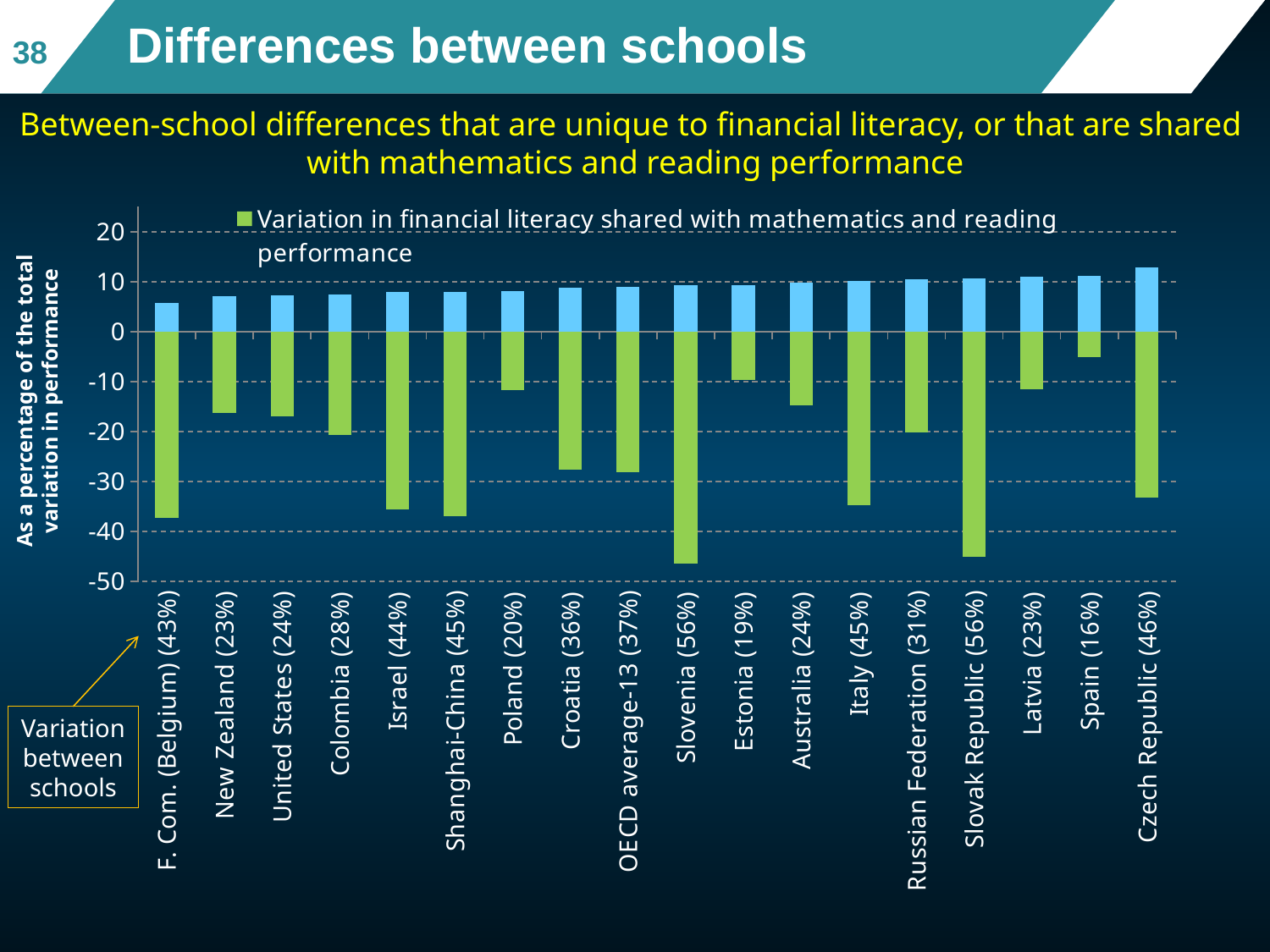
Do the blue bars rise or fall moving from left to right along the x axis? rise Is the green bar value for Australia greater or less than -10? less Which category has the tallest blue (positive) bar? Czech Republic Which category has the shortest green (negative) bar? Spain (16%) Is the green bar value for Spain greater or less than -10? greater What is the title of the vertical axis? As a percentage of the total variation in performance What kind of chart is shown on the slide? bar chart Is the blue bar value for Czech Republic greater or less than 10? greater How many countries/economies (categories) are shown on the x axis of the chart? 18 Which category has the shortest blue (positive) bar? F. Com. (Belgium) (43%) Which has the longer green (negative) bar, Israel or Colombia? Israel